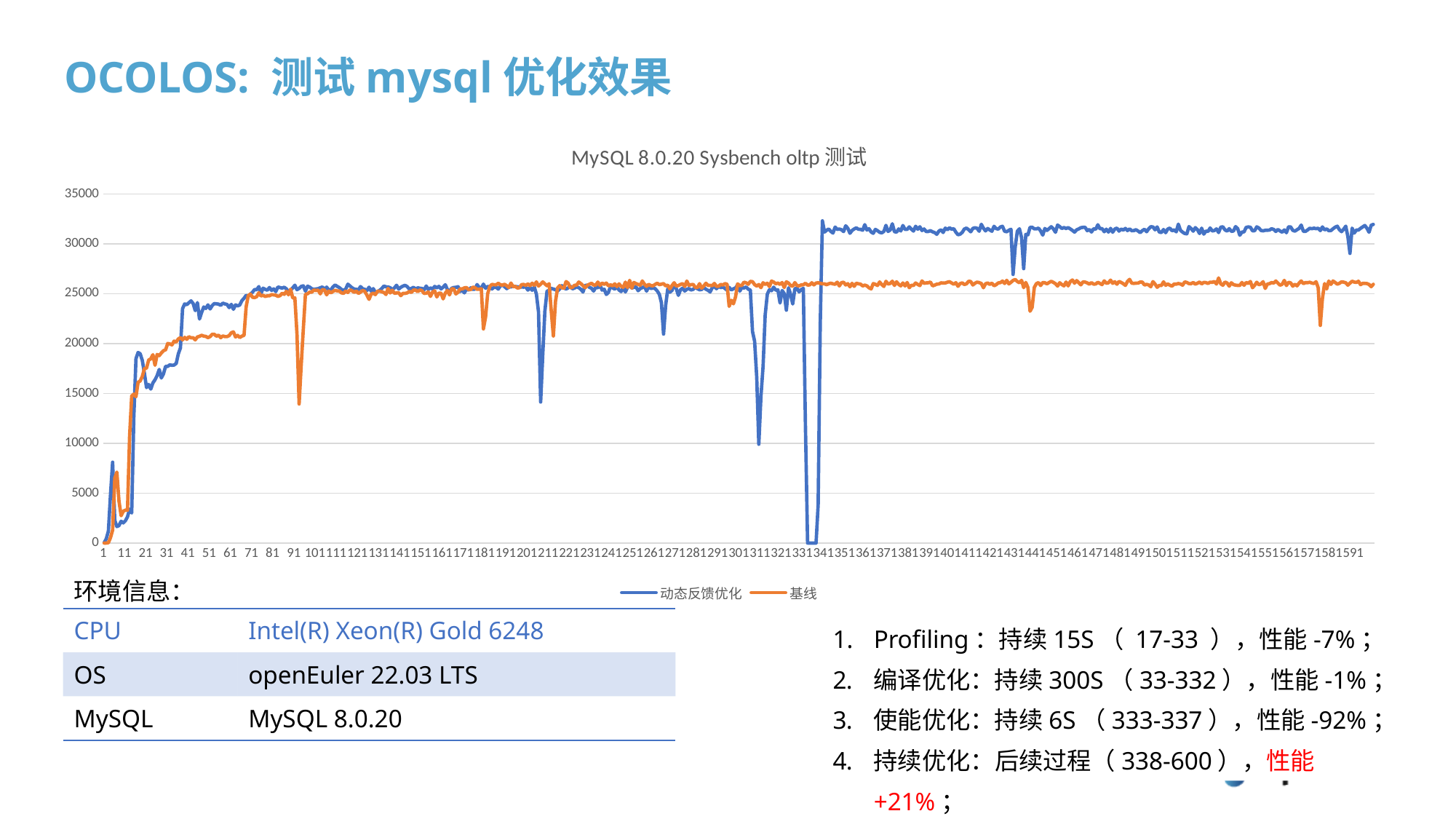
Is the value of the 基线 series at x = 51 greater or less than 25000? less What is the highest value shown on the vertical axis? 35000 Is the value of the 基线 series at x = 500 greater or less than 30000? less Does the 动态反馈优化 series rise or fall between x = 1 and x = 41? rise What is the title of the chart? MySQL 8.0.20 Sysbench oltp 测试 Around x = 335, where the blue line drops sharply, which series has the higher value, 动态反馈优化 or 基线? 基线 Is the value of the 动态反馈优化 series at x = 500 greater or less than 30000? greater At x = 51, which series has the higher value, 动态反馈优化 or 基线? 动态反馈优化 Which series is drawn in orange according to the legend? 基线 What kind of chart is shown on the slide? line chart How many series does the chart legend list? 2 At x = 500, which series has the higher value, 动态反馈优化 or 基线? 动态反馈优化